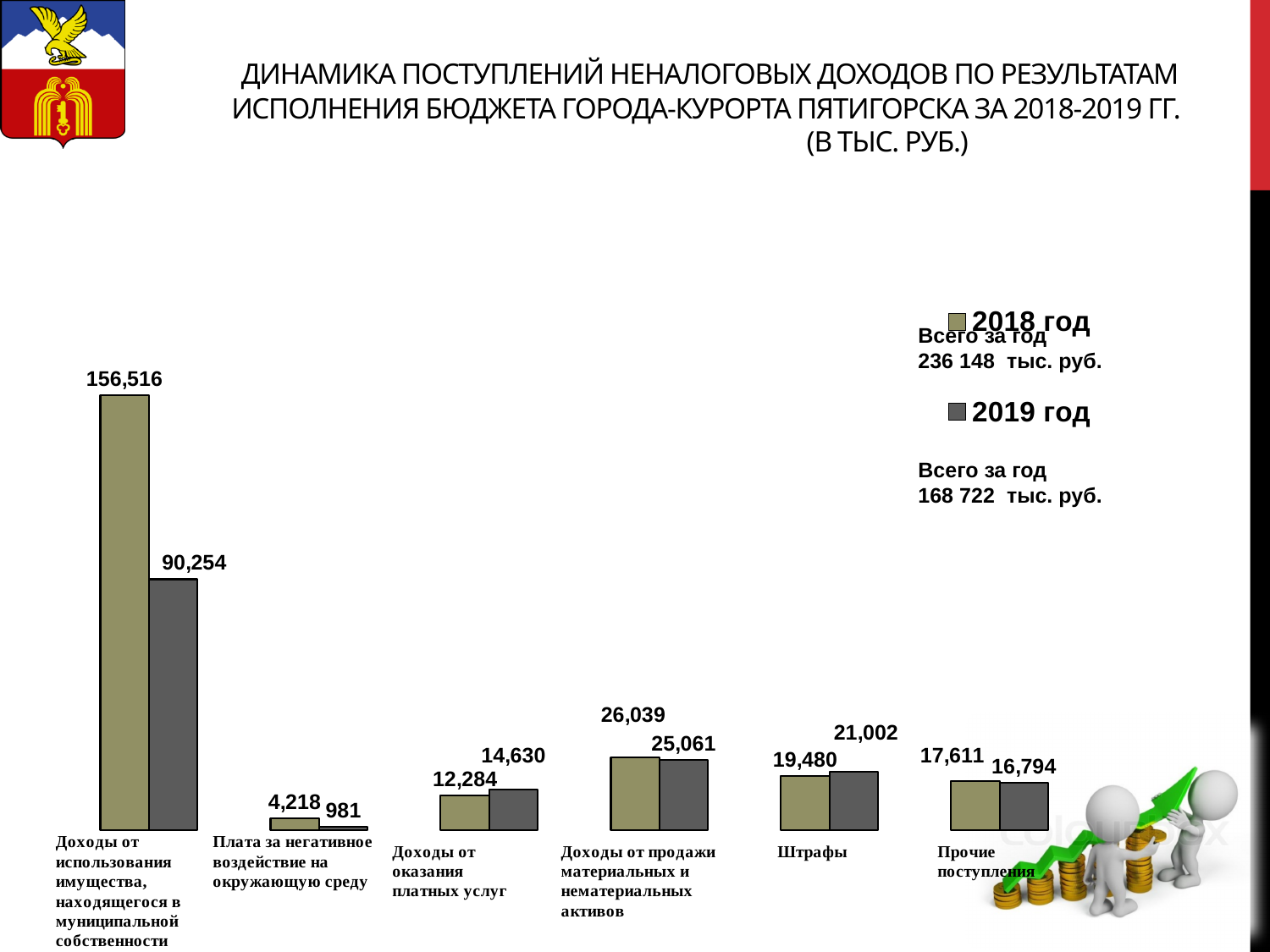
How many series does the legend list? 2 How many categories are shown on the x axis? 6 What is the 2018 год value for Прочие поступления? 17,611 Which category has the highest 2018 год value? Доходы от использования имущества, находящегося в муниципальной собственности What is the 2018 год value for Штрафы? 19,480 What is the difference between the 2018 год and 2019 год values for Доходы от использования имущества, находящегося в муниципальной собственности? 66,262 What kind of chart is shown on the slide? Bar chart For Штрафы, which year has the larger value, 2018 год or 2019 год? 2019 год Which category has the lowest 2019 год value? Плата за негативное воздействие на окружающую среду What is the 2019 год value for Плата за негативное воздействие на окружающую среду? 981 What is the difference between the 2018 год and 2019 год values for Доходы от продажи материальных и нематериальных активов? 978 What is the 2019 год value for Доходы от оказания платных услуг? 14,630